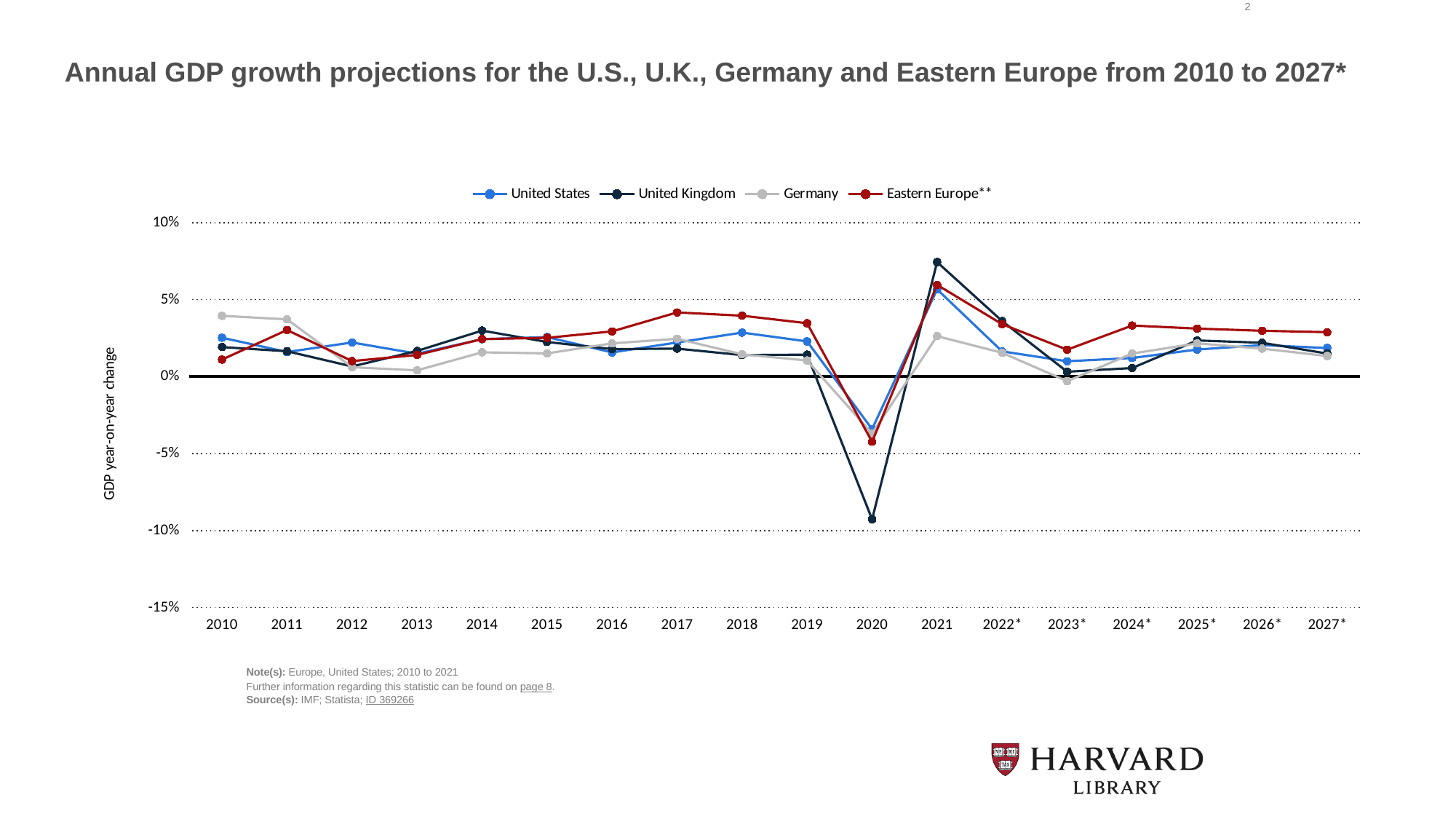
In which year does the United Kingdom line reach its lowest value? 2020 How many series does the legend list? 4 Is the value for the United Kingdom in 2021 greater or less than 5%? greater In 2010, which is larger: the value for Germany or the value for Eastern Europe? Germany Which series has the lowest value in 2020? United Kingdom What is the label on the vertical axis? GDP year-on-year change Is the value for the United Kingdom in 2020 greater or less than -5%? less How many years are shown along the x axis? 18 Which series has the highest value in 2021? United Kingdom Does the Eastern Europe line rise or fall from 2020 to 2021? rise Is the value for the United States in 2020 greater or less than -5%? greater What kind of chart is shown on the slide? line chart